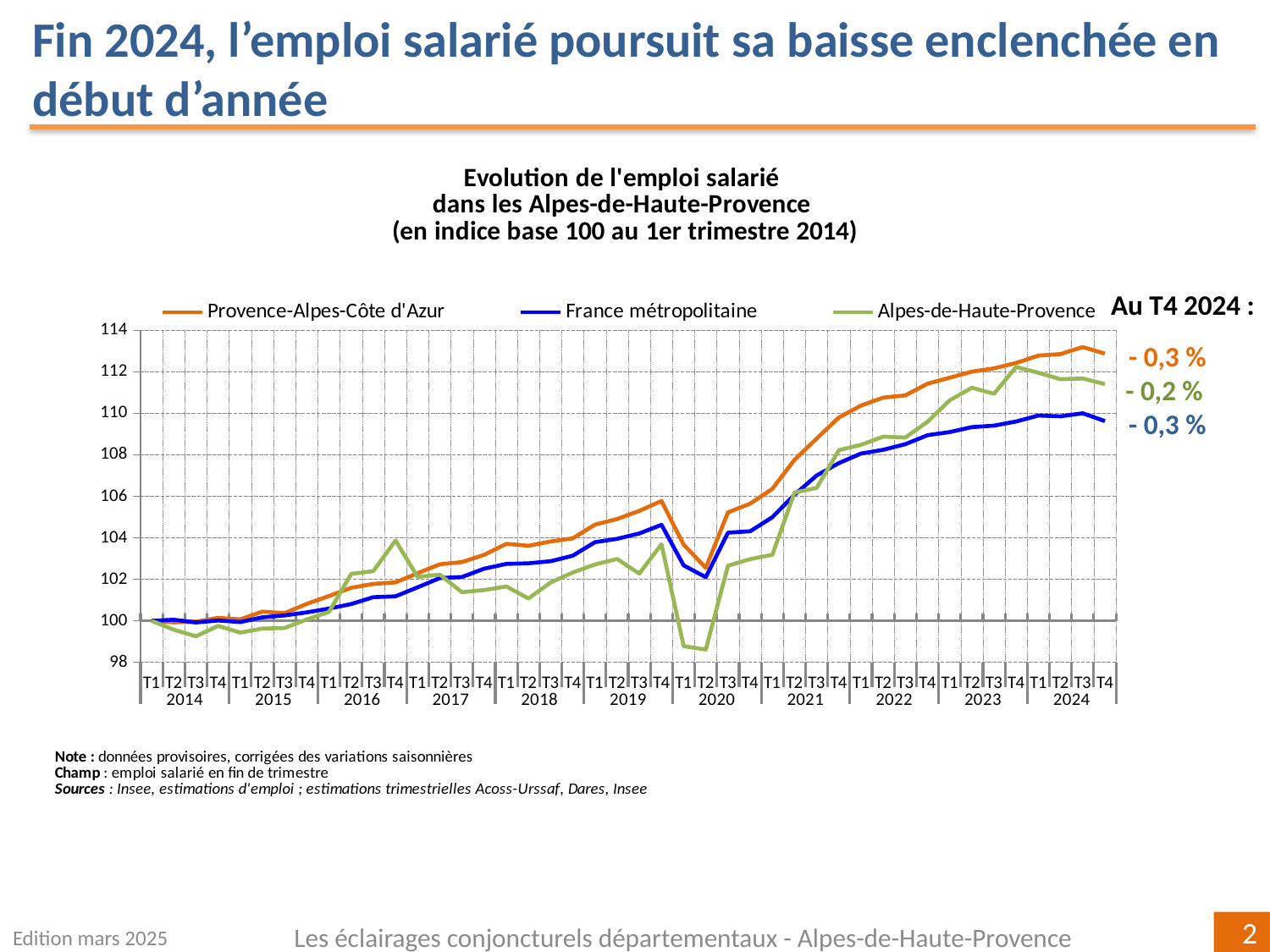
Is the value for Alpes-de-Haute-Provence at T2 2020 greater or less than 100? less How many series does the legend list? 3 How many years are labelled along the x axis? 11 Overall, do the series rise or fall between T1 2014 and T4 2024? rise What kind of chart is shown on the slide? line chart Which series has the highest value at T4 2024? Provence-Alpes-Côte d'Azur According to the annotation 'Au T4 2024', what is the change shown for Alpes-de-Haute-Provence? - 0,2 % At T2 2020, which is higher: Provence-Alpes-Côte d'Azur or Alpes-de-Haute-Provence? Provence-Alpes-Côte d'Azur Is the value for Provence-Alpes-Côte d'Azur at T4 2024 greater or less than 112? greater According to the annotation 'Au T4 2024', what is the change shown for Provence-Alpes-Côte d'Azur? - 0,3 % What is the index value of all three series at T1 2014? 100 Which series has the lowest value at T4 2024? France métropolitaine